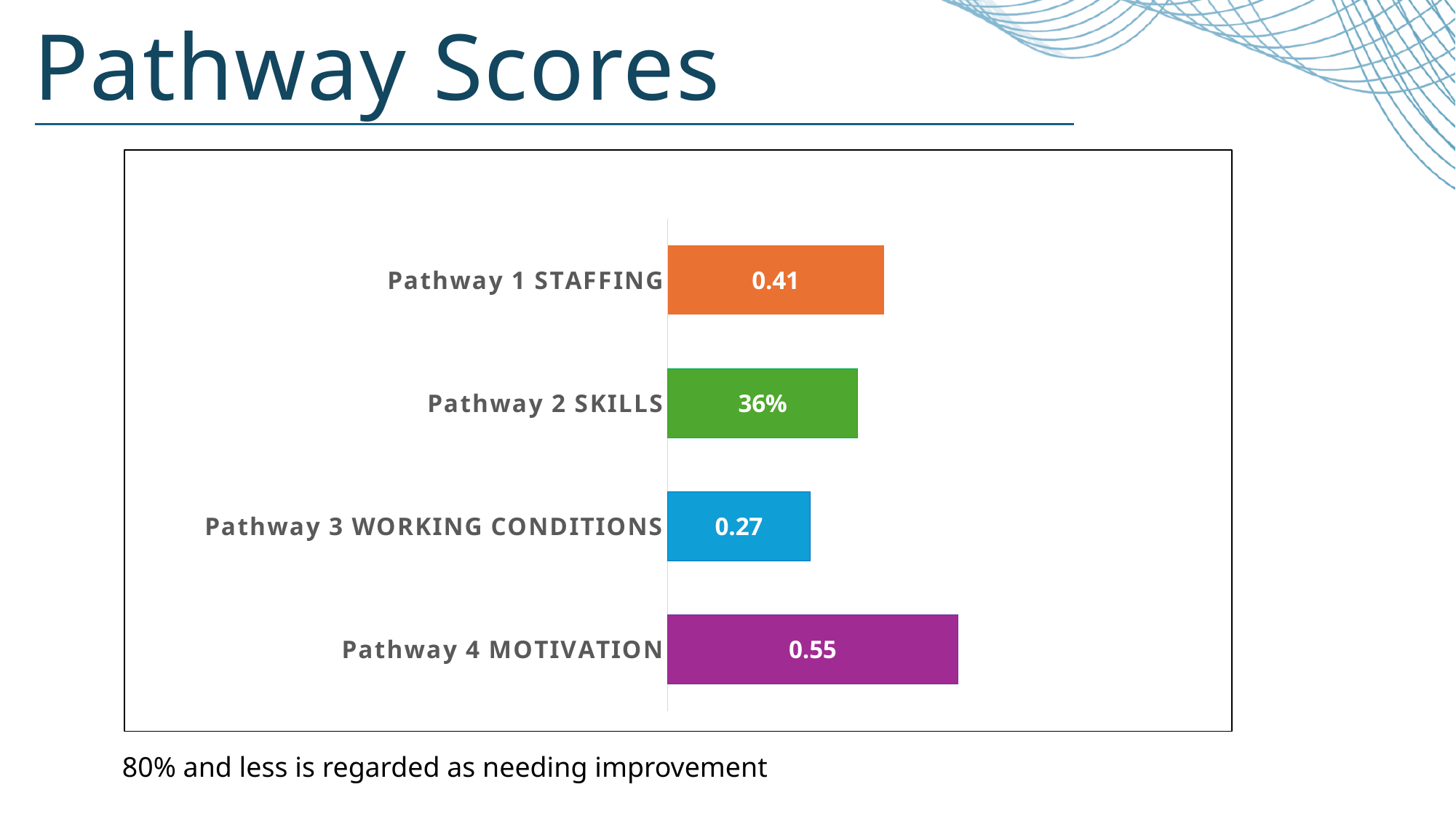
How many pathways are plotted in the chart? 4 What kind of chart is shown on the slide? Bar chart Which pathway has the lowest score? Pathway 3 WORKING CONDITIONS What is the difference between the values for Pathway 4 MOTIVATION and Pathway 1 STAFFING? 0.14 What is the value shown for Pathway 1 STAFFING? 0.41 What is the value shown for Pathway 2 SKILLS? 36% Which has the larger value, Pathway 1 STAFFING or Pathway 3 WORKING CONDITIONS? Pathway 1 STAFFING What is the value shown for Pathway 4 MOTIVATION? 0.55 Which pathway has the highest score? Pathway 4 MOTIVATION What is the difference between the values for Pathway 4 MOTIVATION and Pathway 3 WORKING CONDITIONS? 0.28 What is the value shown for Pathway 3 WORKING CONDITIONS? 0.27 What is the title of the slide? Pathway Scores